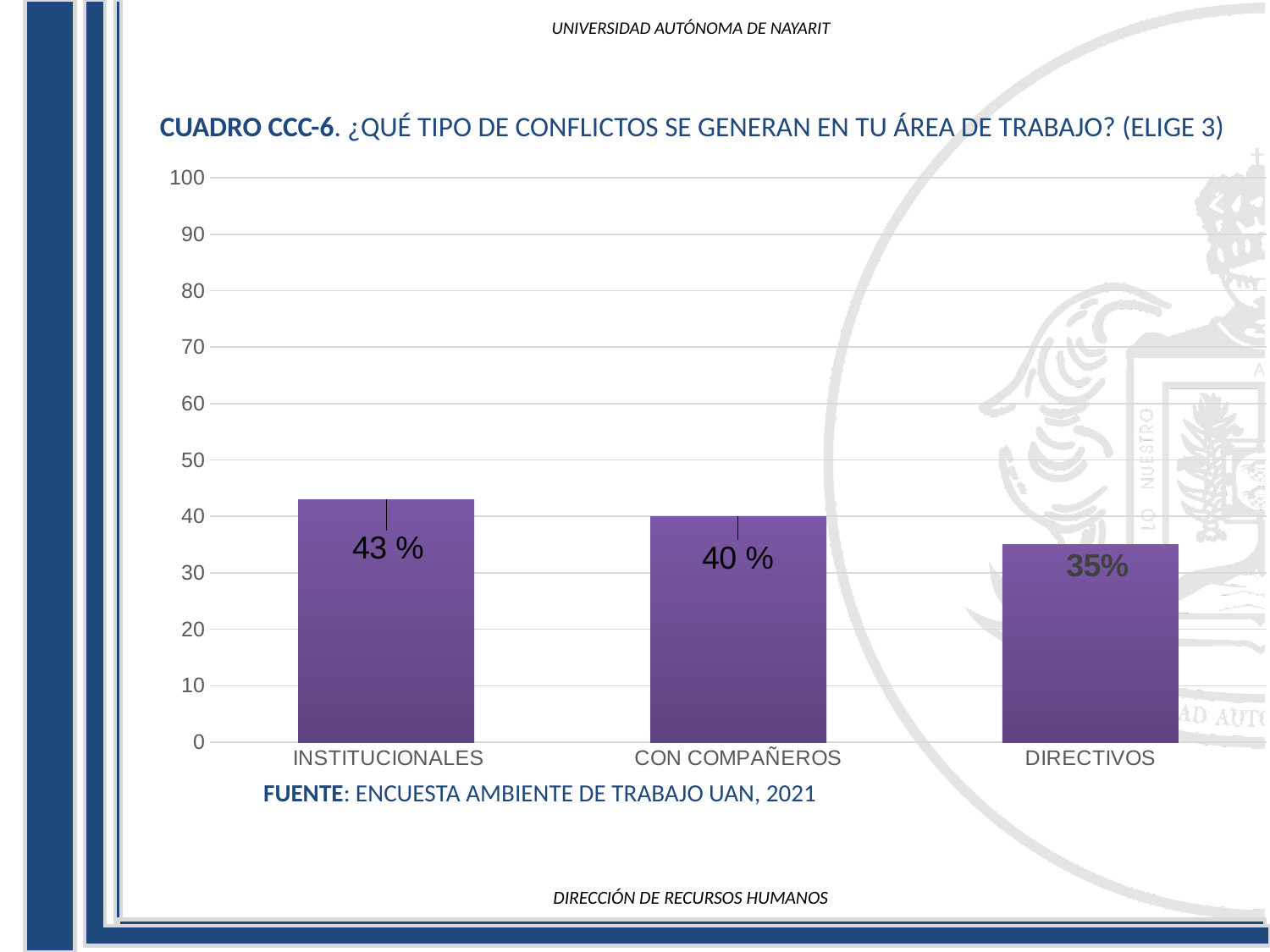
What is the value for DIRECTIVOS? 35% Is the value for DIRECTIVOS greater or less than 50? less Which is larger, the value for CON COMPAÑEROS or the value for DIRECTIVOS? CON COMPAÑEROS What is the difference between the values for INSTITUCIONALES and CON COMPAÑEROS? 3% What is the value for CON COMPAÑEROS? 40 % How many categories are shown on the x axis? 3 Do the values rise or fall from left to right along the x axis? fall What is the difference between the values for INSTITUCIONALES and DIRECTIVOS? 8% What is the value for INSTITUCIONALES? 43 % What kind of chart is shown on the slide? bar chart Which category has the highest value? INSTITUCIONALES Which category has the lowest value? DIRECTIVOS